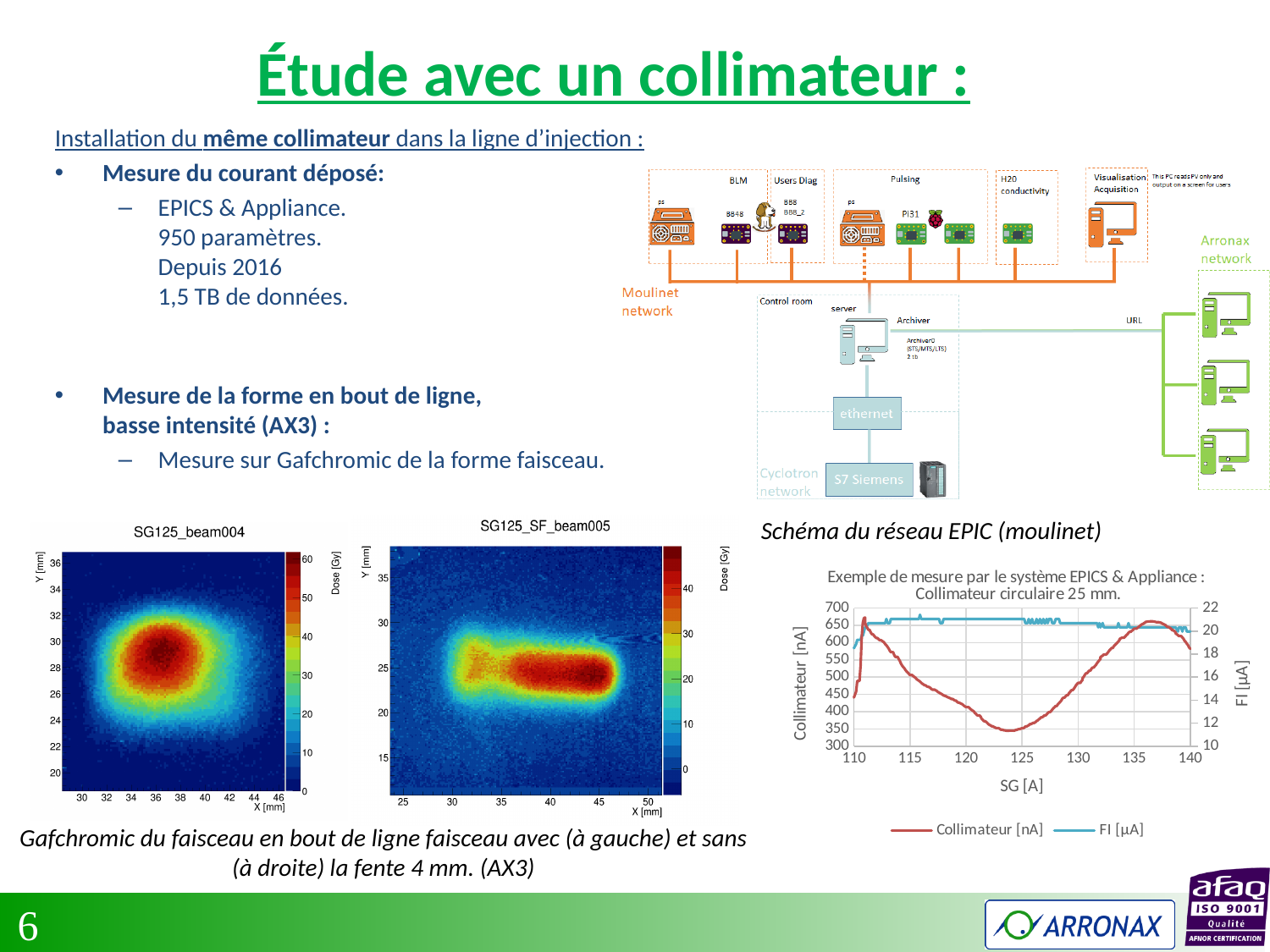
In the 'Exemple de mesure par le système EPICS & Appliance' chart, what are the two series named in the legend? Collimateur [nA] and FI [µA] In the 'Exemple de mesure par le système EPICS & Appliance' chart, what is the label of the x axis? SG [A] In the 'Exemple de mesure par le système EPICS & Appliance' chart, does the Collimateur [nA] series rise or fall as SG goes from 115 A to 125 A? fall In the 'Exemple de mesure par le système EPICS & Appliance' chart, is the Collimateur [nA] value larger at SG = 115 A or at SG = 125 A? SG = 115 A In the 'Exemple de mesure par le système EPICS & Appliance' chart, is the FI [µA] value at SG = 120 A greater or less than 18? greater In the 'Exemple de mesure par le système EPICS & Appliance' chart, which series is drawn in red? Collimateur [nA] What kind of chart is the 'Exemple de mesure par le système EPICS & Appliance' chart at the bottom right of the slide? line chart In the 'Exemple de mesure par le système EPICS & Appliance' chart, is the Collimateur [nA] value at SG = 125 A greater or less than 400? less In the 'Exemple de mesure par le système EPICS & Appliance' chart, is the Collimateur [nA] value at SG = 135 A greater or less than 550? greater In the 'Exemple de mesure par le système EPICS & Appliance' chart, does the Collimateur [nA] series rise or fall as SG goes from 125 A to 135 A? rise How many series does the legend of the 'Exemple de mesure par le système EPICS & Appliance' chart list? 2